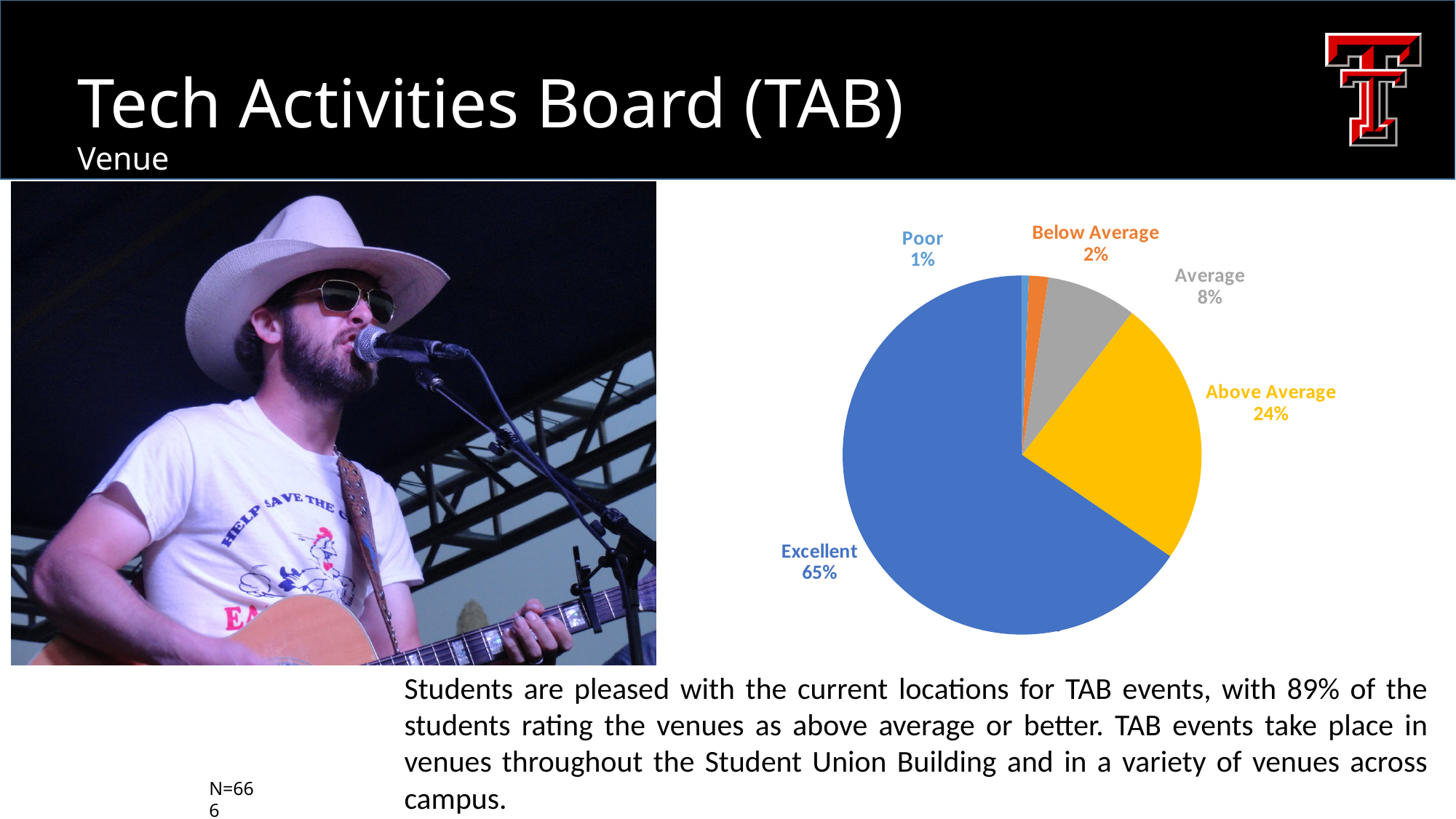
What is the difference in percentage points between the Excellent and Above Average slices? 41 What percentage of students rated the venue as Average? 8% Which rating category has the largest share of the pie? Excellent What kind of chart is shown on the slide? Pie chart Which rating category has the smallest share of the pie? Poor How many rating categories are shown in the pie chart? 5 What percentage of students rated the venue as Below Average? 2% Which slice is larger, Average or Below Average? Average What colour is the Above Average slice of the pie chart? Yellow What percentage of students rated the venue as Above Average? 24% What percentage of students rated the venue as Poor? 1% What percentage of students rated the venue as Excellent? 65%